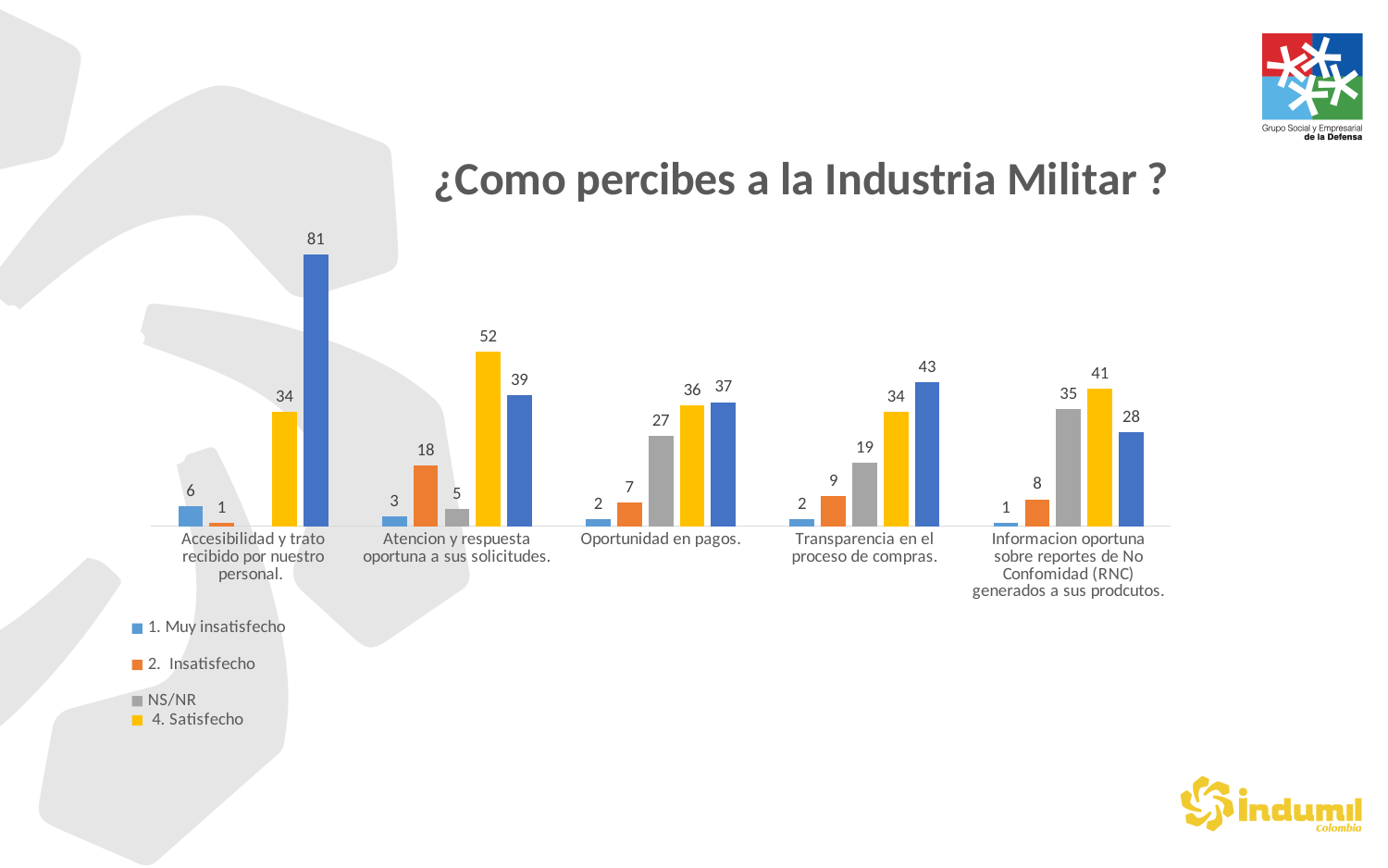
How many series does the legend list? 4 What is the value of the 4. Satisfecho bar for "Atencion y respuesta oportuna a sus solicitudes."? 52 How many categories are shown on the x axis? 5 What is the title of the chart? ¿Como percibes a la Industria Militar ? What is the highest value shown on the chart? 81 What is the value of the 1. Muy insatisfecho bar for "Accesibilidad y trato recibido por nuestro personal."? 6 Which category has the lowest 2. Insatisfecho value? Accesibilidad y trato recibido por nuestro personal. Which is larger: the NS/NR value for "Informacion oportuna sobre reportes de No Confomidad (RNC) generados a sus prodcutos." or the NS/NR value for "Transparencia en el proceso de compras."? Informacion oportuna sobre reportes de No Confomidad (RNC) generados a sus prodcutos. Which category has the highest 4. Satisfecho value? Atencion y respuesta oportuna a sus solicitudes. What is the value of the 2. Insatisfecho bar for "Transparencia en el proceso de compras."? 9 What is the value of the NS/NR bar for "Oportunidad en pagos."? 27 What is the difference between the 4. Satisfecho values for "Atencion y respuesta oportuna a sus solicitudes." and "Accesibilidad y trato recibido por nuestro personal."? 18